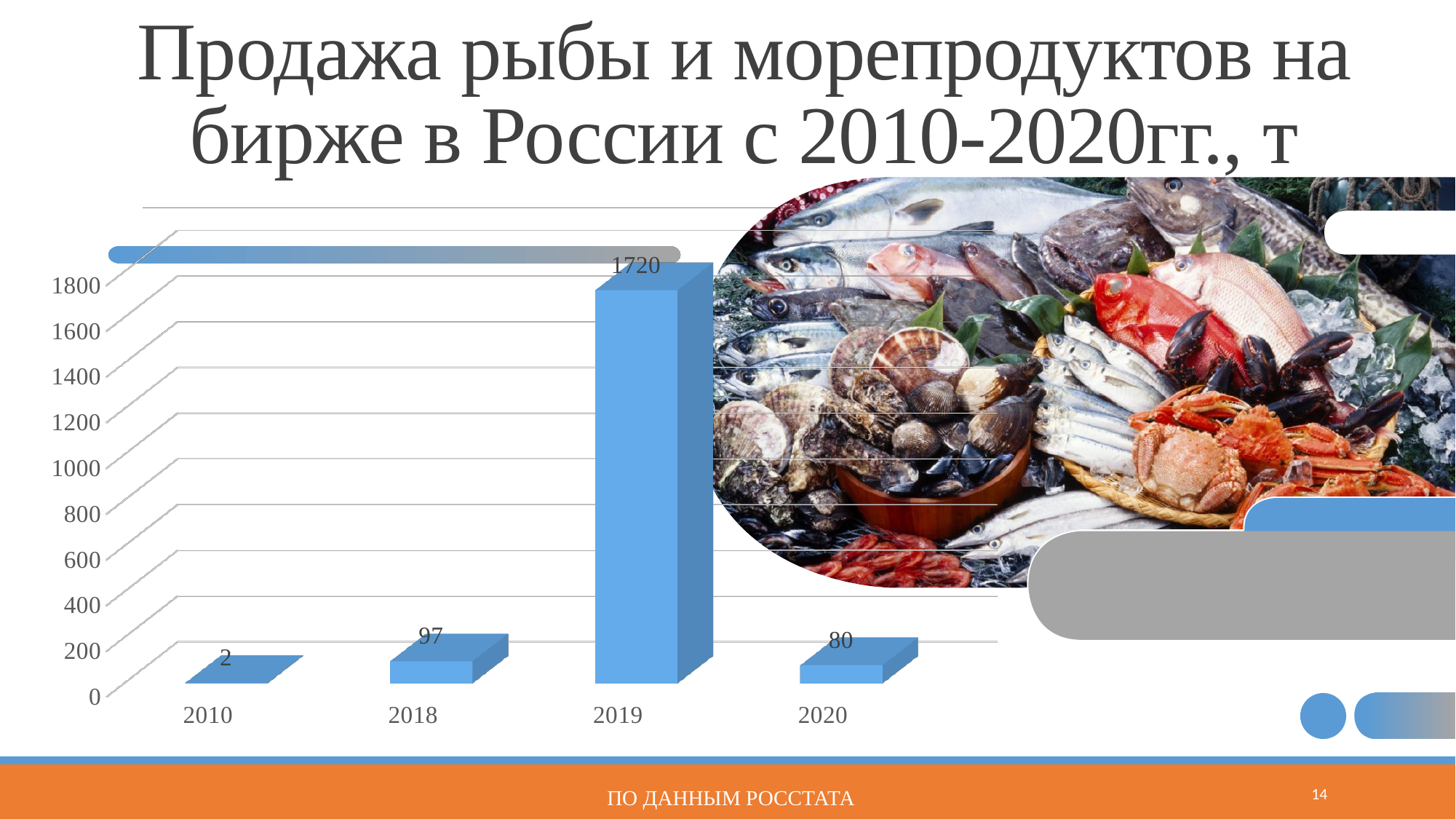
Which is larger, the value for 2018 or the value for 2020? 2018 What is the value for 2019? 1720 Is the value for 2019 greater or less than 1600? greater How many years are shown on the x axis? 4 What is the difference between the values for 2018 and 2020? 17 Which year has the highest value? 2019 What is the difference between the values for 2019 and 2020? 1640 What kind of chart is shown on the slide? bar chart What is the value for 2010? 2 What is the value for 2018? 97 Which year has the lowest value? 2010 What is the value for 2020? 80